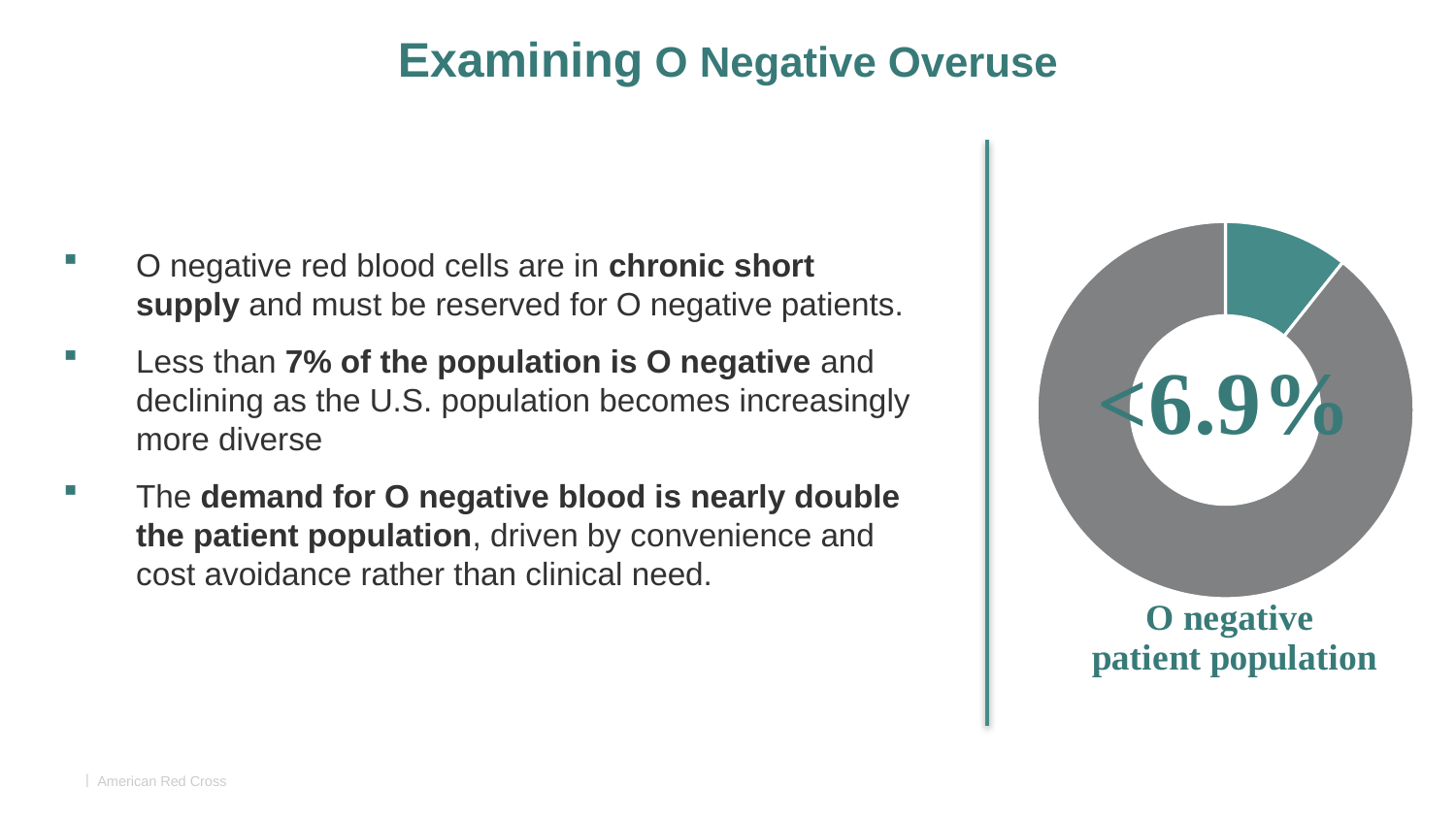
Which slice of the donut chart is larger, the teal slice or the gray slice? The gray slice What share of the donut chart does the teal slice represent, as printed in the centre of the chart? <6.9% What colour is the smaller slice of the donut chart? Teal What value is printed in the centre of the donut chart? <6.9% What kind of chart is shown on the right side of the slide? Donut (pie) chart What is the label printed below the donut chart? O negative patient population How many slices does the donut chart have? 2